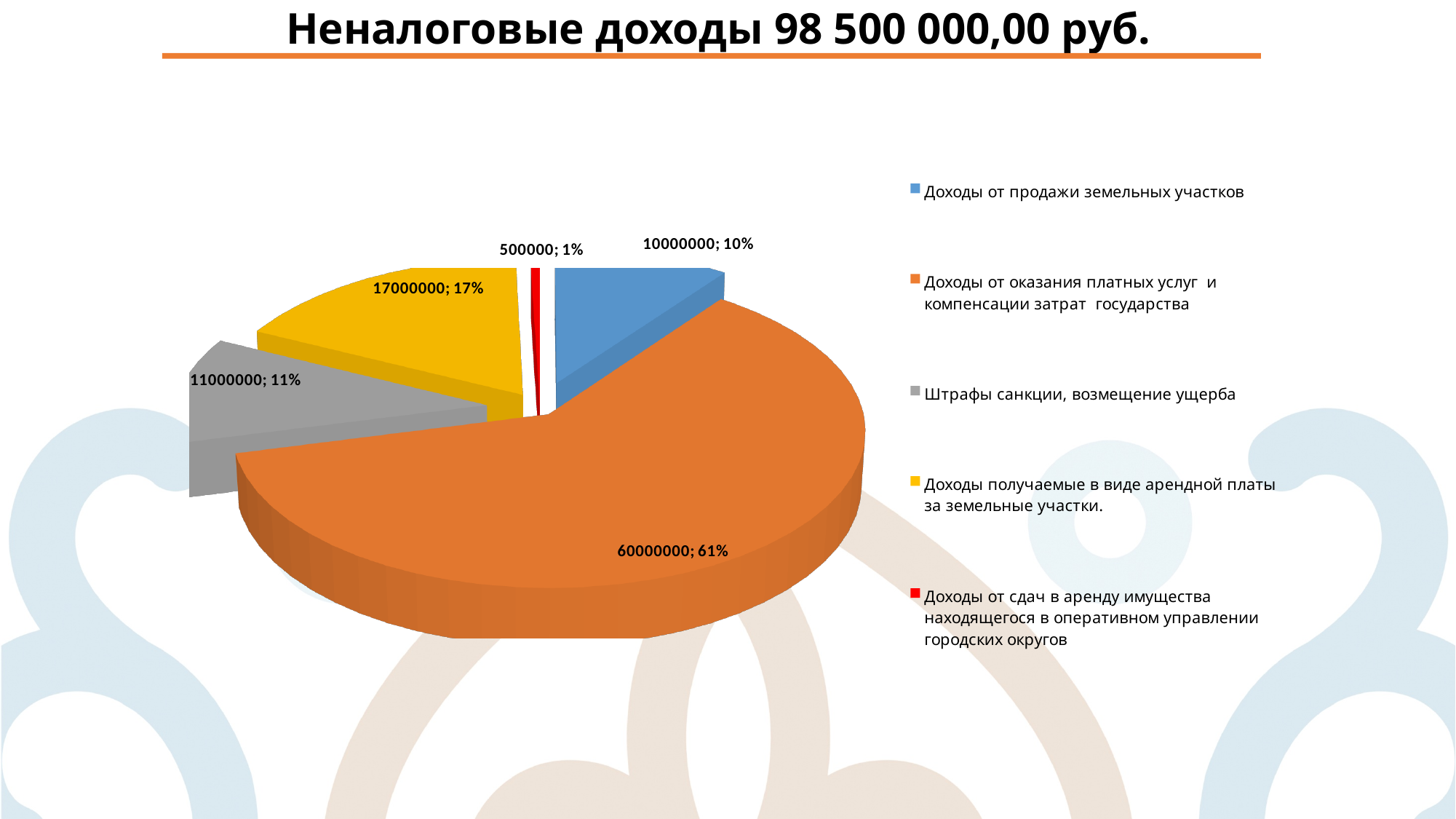
What is the value for "Доходы получаемые в виде арендной платы за земельные участки."? 17000000 Which category has the smallest slice of the pie? Доходы от сдач в аренду имущества находящегося в оперативном управлении городских округов What is the value for "Доходы от продажи земельных участков"? 10000000 What is the title of the slide? Неналоговые доходы 98 500 000,00 руб. How many slices does the pie chart have? 5 What kind of chart is shown on the slide? Pie chart How many entries does the legend list? 5 What is the value for "Штрафы санкции, возмещение ущерба"? 11000000 Which category has the largest slice of the pie? Доходы от оказания платных услуг и компенсации затрат государства What is the difference between the values for "Доходы получаемые в виде арендной платы за земельные участки." and "Штрафы санкции, возмещение ущерба"? 6000000 What share of the pie does "Доходы от оказания платных услуг и компенсации затрат государства" represent? 61% What is the value for "Доходы от сдач в аренду имущества находящегося в оперативном управлении городских округов"? 500000